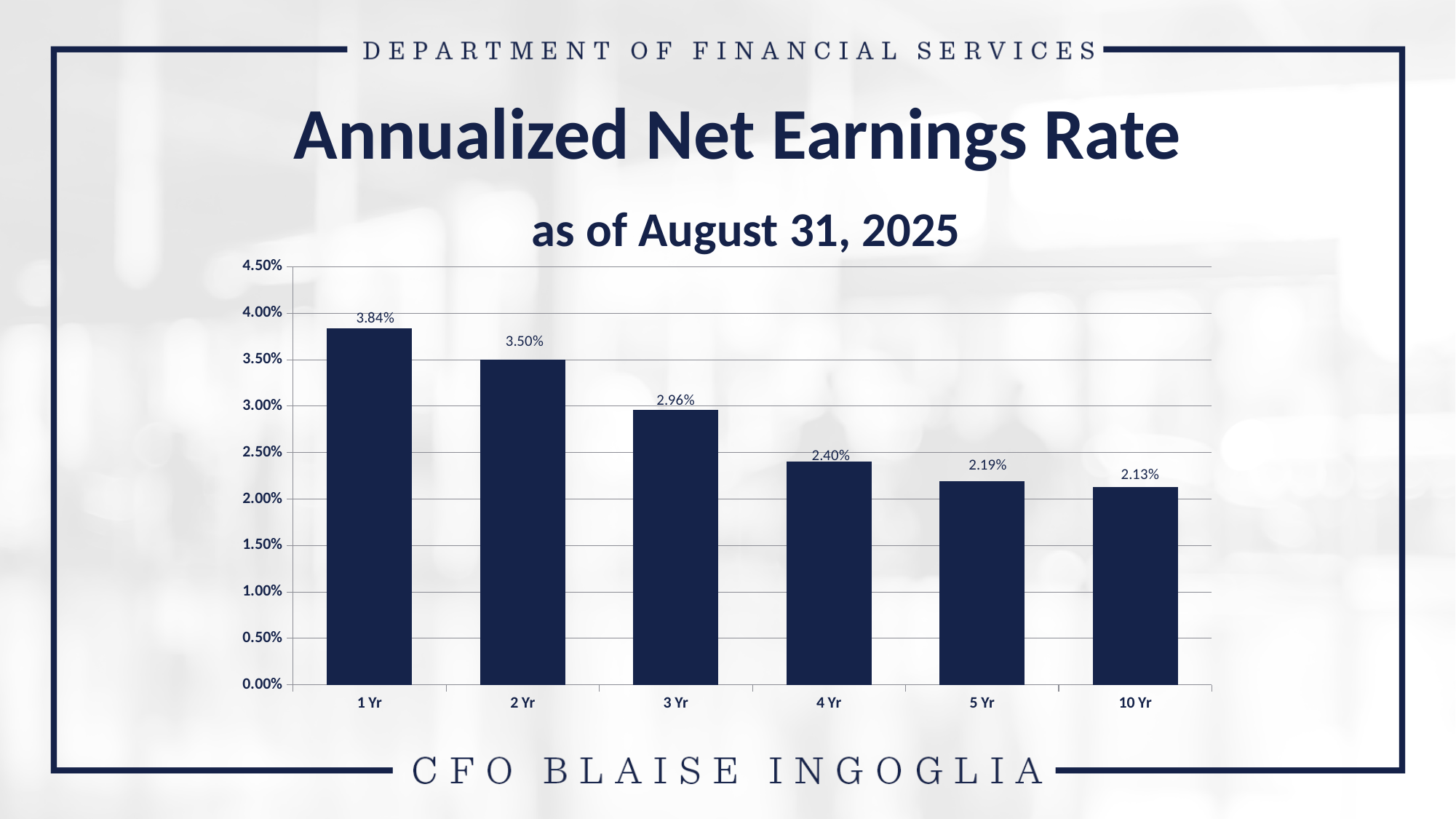
Which period has the lowest annualized net earnings rate? 10 Yr What kind of chart is shown on the slide? bar chart What is the annualized net earnings rate for 10 Yr? 2.13% Which period has the highest annualized net earnings rate? 1 Yr Which is larger, the 2 Yr rate or the 3 Yr rate? 2 Yr Do the values rise or fall moving from 1 Yr to 10 Yr along the x axis? fall What is the annualized net earnings rate for 3 Yr? 2.96% What is the annualized net earnings rate for 1 Yr? 3.84% What is the difference between the 4 Yr and 5 Yr annualized net earnings rates? 0.21% Is the value for 4 Yr greater or less than 2.50%? less What is the difference between the 1 Yr and 2 Yr annualized net earnings rates? 0.34% How many periods are shown on the x axis? 6